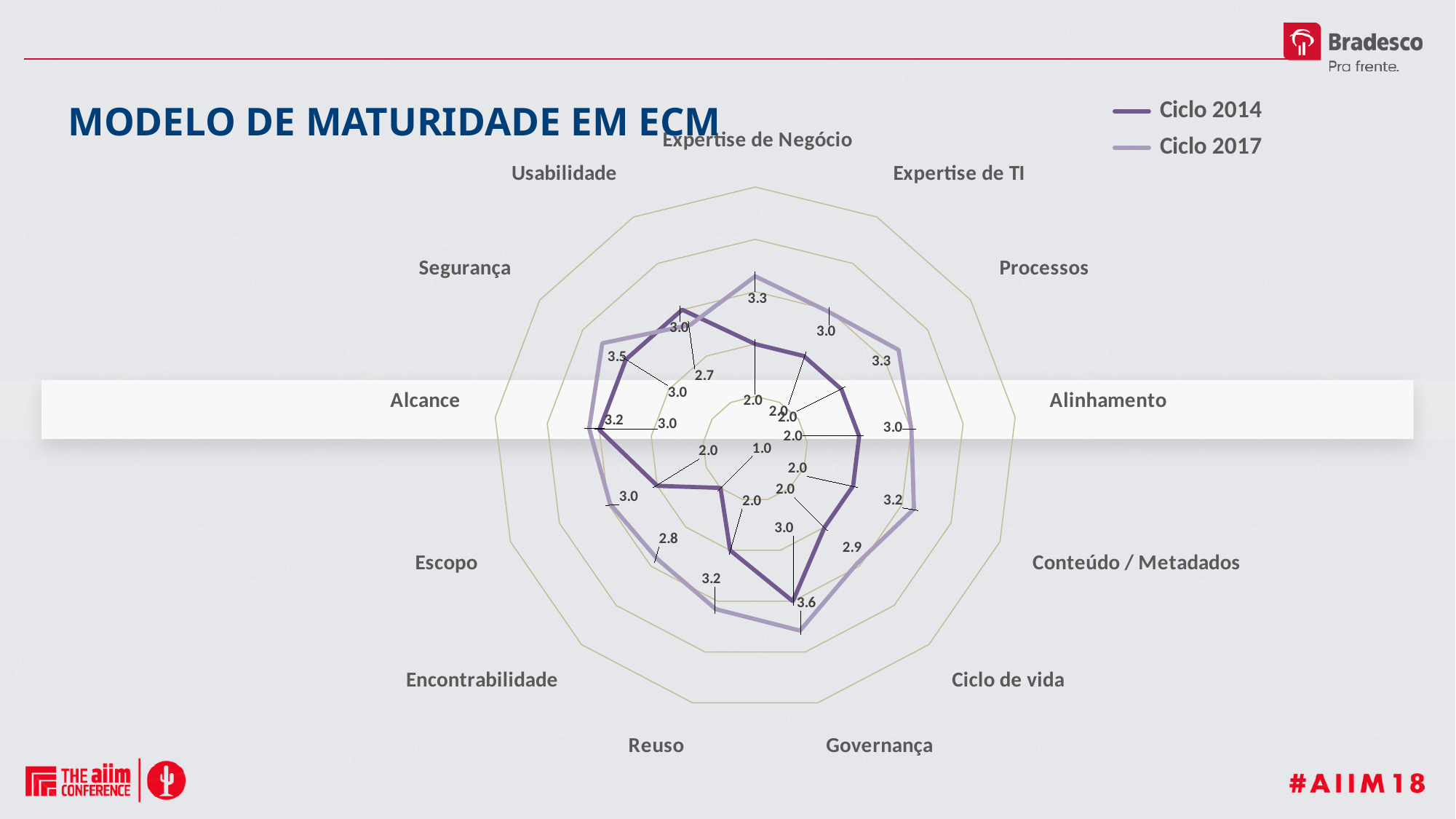
What is the Ciclo 2017 value for Governança? 3.6 What is the difference between the Ciclo 2017 and Ciclo 2014 values for Governança? 0.6 What is the Ciclo 2017 value for Segurança? 3.5 How many series does the legend list? 2 How many categories (axes) does the radar chart have? 13 Which category has the lowest Ciclo 2014 value? Encontrabilidade What is the Ciclo 2017 value for Expertise de Negócio? 3.3 Which category has the highest Ciclo 2017 value? Governança What is the Ciclo 2017 value for Ciclo de vida? 2.9 Which is larger for Ciclo 2017: Governança or Ciclo de vida? Governança What kind of chart is shown on the slide? Radar chart What is the Ciclo 2014 value for Encontrabilidade? 1.0